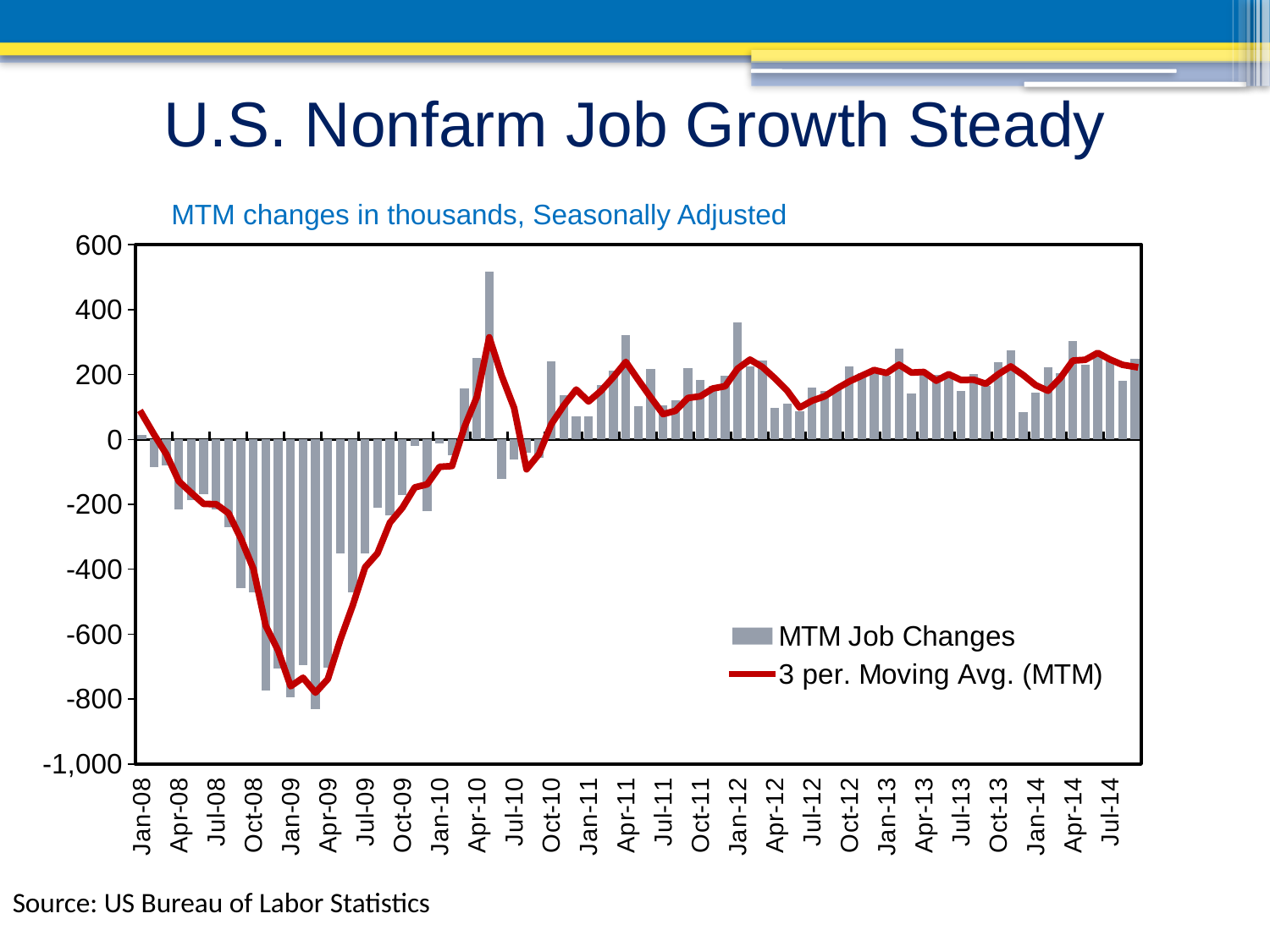
Is the 3 per. Moving Avg. (MTM) line at Apr-09 greater or less than -600? less Which is larger, the MTM Job Changes bar at Apr-09 or at Jan-12? Jan-12 Is the MTM Job Changes bar at Jan-14 greater or less than 200? less Is the MTM Job Changes bar at Apr-09 greater or less than -600? less In which year does the highest MTM Job Changes bar occur? 2010 What kind of chart is shown on the slide? A bar chart with a line overlay What is the name of the series drawn as a red line? 3 per. Moving Avg. (MTM) What is the lowest value labelled on the y axis? -1,000 In which year does the lowest MTM Job Changes bar occur? 2009 How many series does the legend list? 2